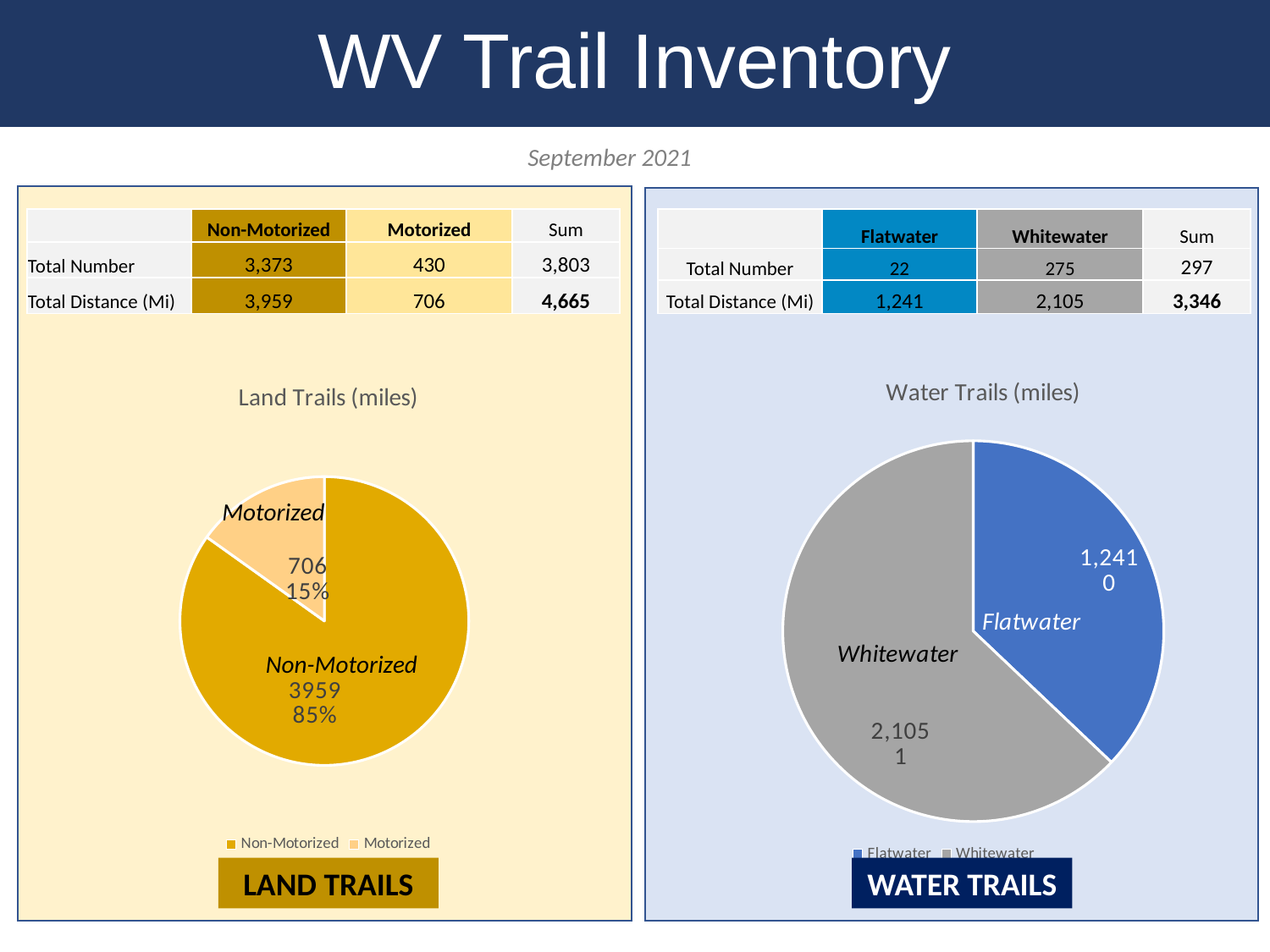
In the Land Trails (miles) pie chart, what value is shown for Non-Motorized? 3959 In the Water Trails (miles) pie chart, is the value for Whitewater larger or smaller than the value for Flatwater? larger In the Land Trails (miles) pie chart, what share of the pie does Motorized represent? 15% In the Water Trails (miles) pie chart, what value is shown for Whitewater? 2,105 In the Land Trails (miles) pie chart, what value is shown for Motorized? 706 In the Water Trails (miles) pie chart, which slice is the smallest? Flatwater In the Land Trails (miles) pie chart, what share of the pie does Non-Motorized represent? 85% In the Land Trails (miles) pie chart, which slice is the largest? Non-Motorized What type of chart is the Land Trails (miles) chart? pie chart In the Water Trails (miles) pie chart, what value is shown for Flatwater? 1,241 In the Land Trails (miles) pie chart, what is the difference between the Non-Motorized and Motorized values? 3253 How many entries does the legend of the Water Trails (miles) pie chart list? 2